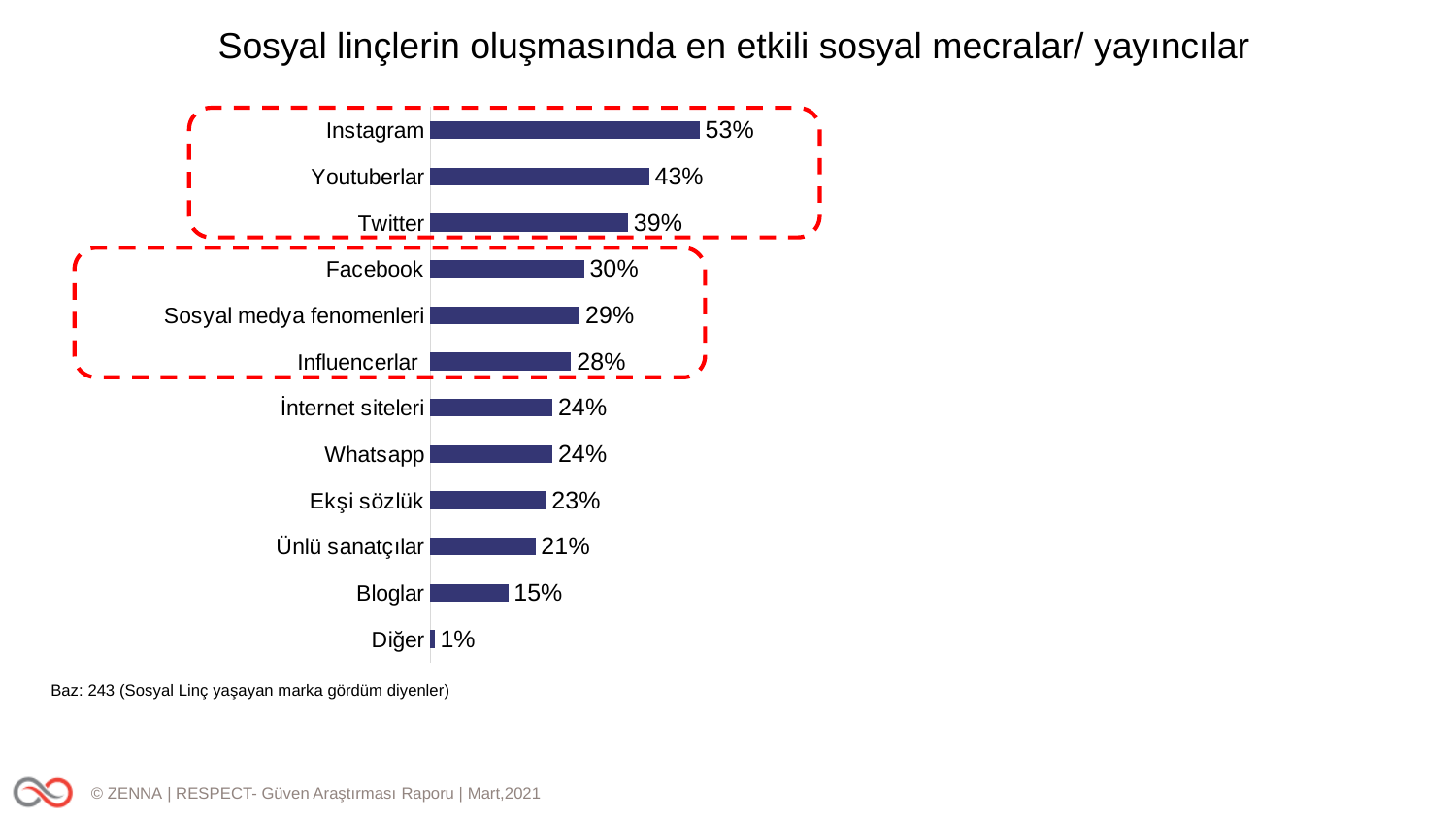
What is the value for Facebook? 30% Which category has the highest value? Instagram What is the difference between the values for Instagram and Youtuberlar? 10% What is the value for Bloglar? 15% What kind of chart is shown on the slide? Bar chart What is the value for Instagram? 53% Which is larger, the value for Ekşi sözlük or the value for Ünlü sanatçılar? Ekşi sözlük What is the difference between the values for Twitter and Facebook? 9% How many categories are shown in the chart? 12 What is the base (Baz) stated below the chart? 243 Which category has the lowest value? Diğer What is the title of the chart? Sosyal linçlerin oluşmasında en etkili sosyal mecralar/ yayıncılar